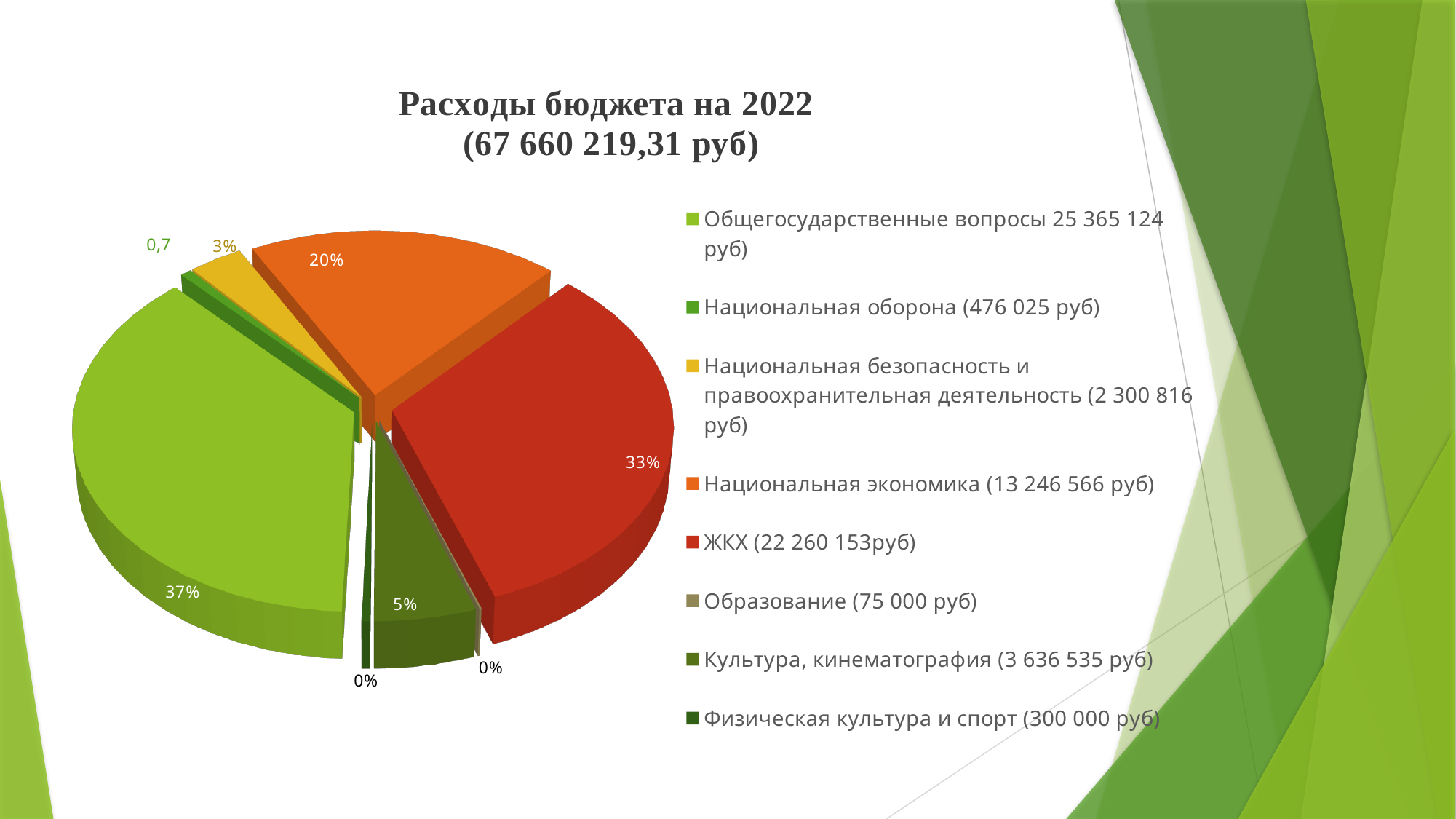
Which is larger, the slice for ЖКХ or the slice for Национальная экономика? ЖКХ What share of the pie is labelled for Национальная безопасность и правоохранительная деятельность? 3% Which category has the largest slice of the pie? Общегосударственные вопросы What is the title of the chart? Расходы бюджета на 2022 (67 660 219,31 руб) How many categories does the legend list? 8 What is the difference in percentage points between the Общегосударственные вопросы slice and the ЖКХ slice? 4 What kind of chart is shown on the slide? pie chart What share of the pie is labelled for Общегосударственные вопросы? 37% What share of the pie is labelled for ЖКХ? 33% What amount in rubles does the legend give for Национальная оборона? 476 025 руб